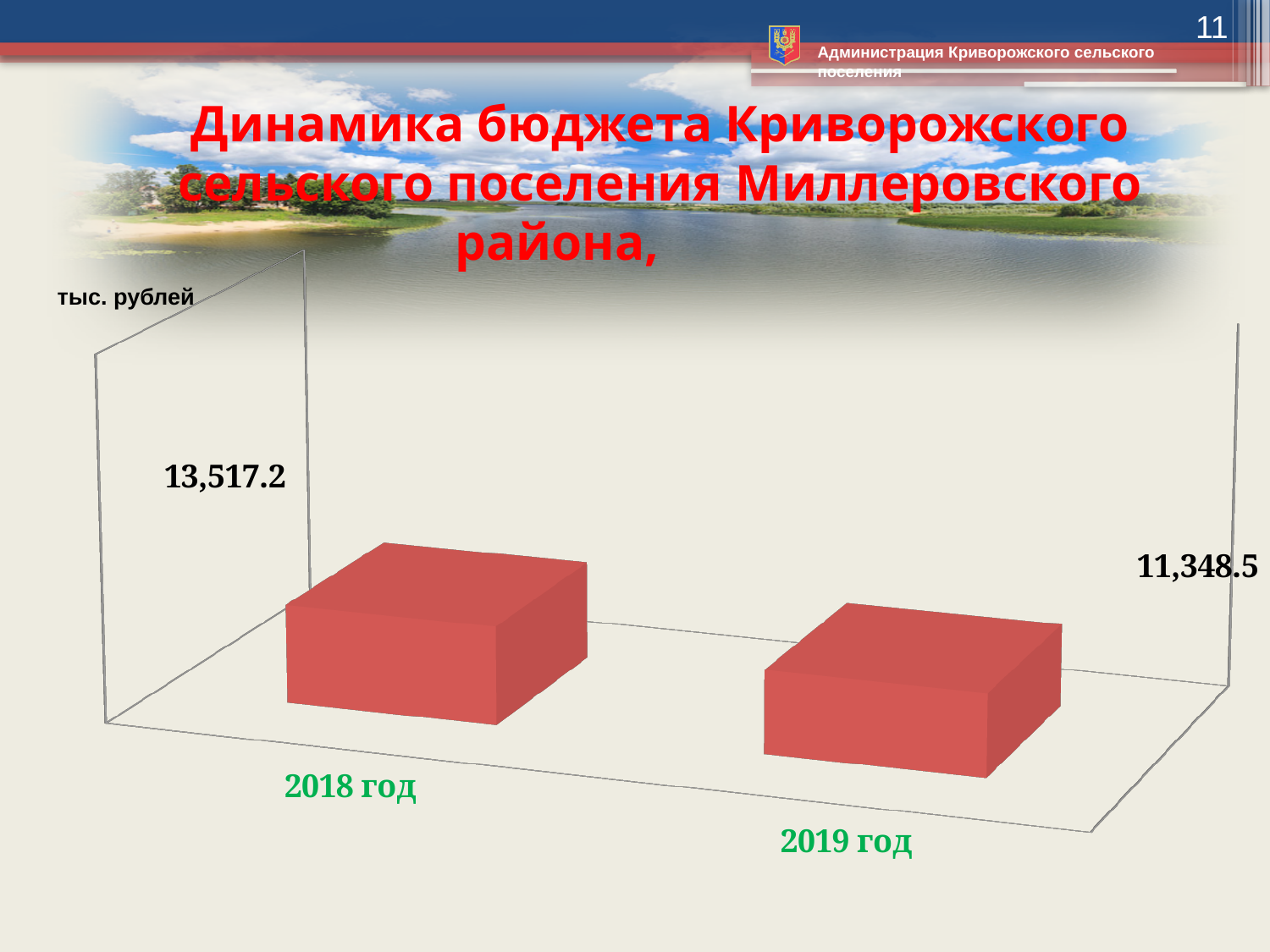
How many years (categories) are plotted in the chart? 2 By how much does the 2018 год value exceed the 2019 год value? 2,168.7 What is the budget value shown for 2019 год? 11,348.5 What is the budget value shown for 2018 год? 13,517.2 Which year has the higher budget value? 2018 год Does the budget value rise or fall from 2018 год to 2019 год? fall What colour are the bars in the chart? red What kind of chart is shown on the slide? bar chart In what units are the chart values expressed, according to the label on the slide? тыс. рублей Is the value for 2018 год larger or smaller than the value for 2019 год? larger Which year has the lower budget value? 2019 год